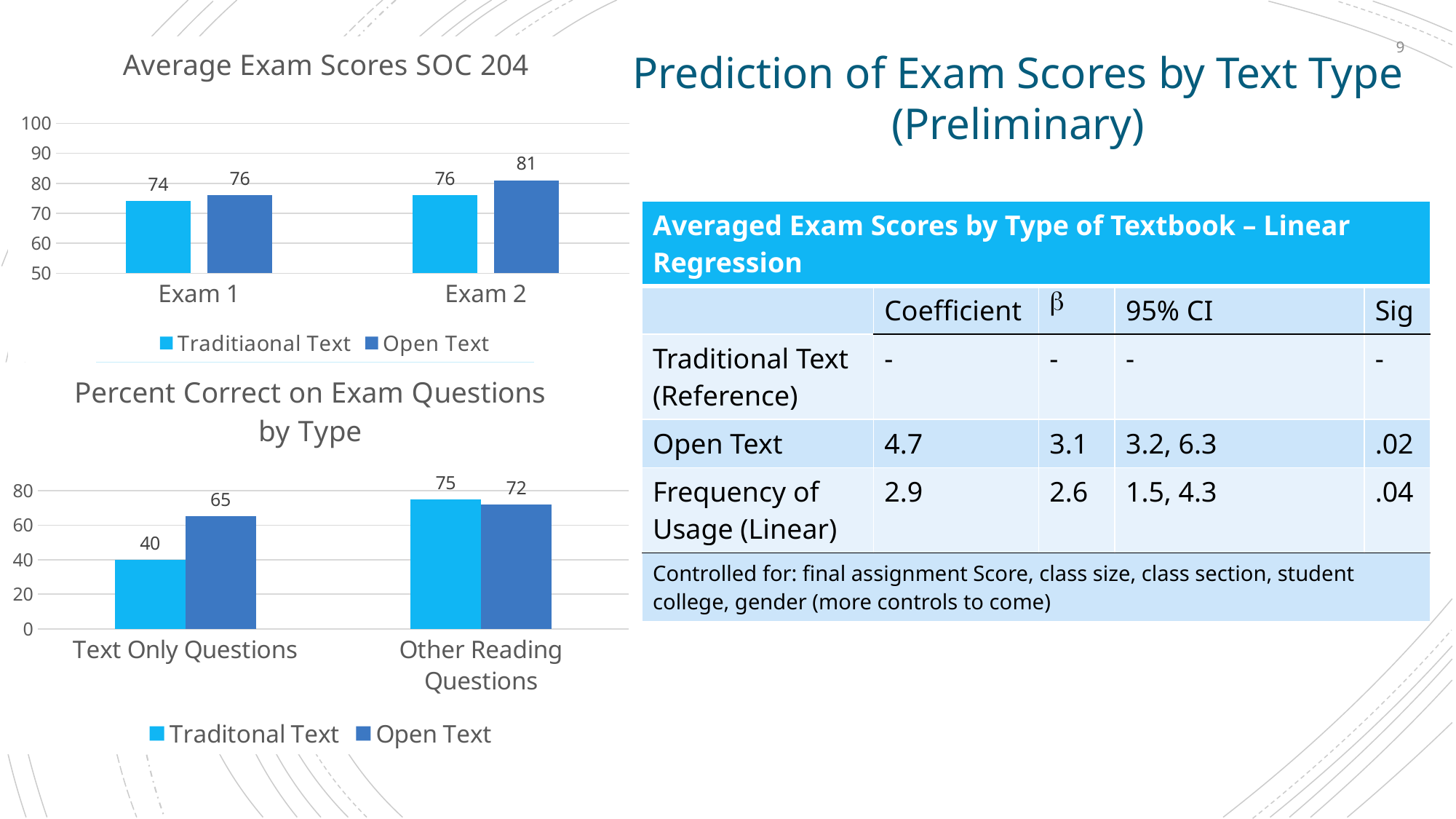
In the 'Percent Correct on Exam Questions by Type' chart, what is the value for Traditional Text on Text Only Questions? 40 In the 'Percent Correct on Exam Questions by Type' chart, which is larger on Other Reading Questions: Traditional Text or Open Text? Traditional Text In the 'Percent Correct on Exam Questions by Type' chart, which bar is the lowest? Traditional Text, Text Only Questions In the 'Percent Correct on Exam Questions by Type' chart, what is the value for Open Text on Other Reading Questions? 72 In the 'Percent Correct on Exam Questions by Type' chart, how many categories are shown on the x axis? 2 In the 'Average Exam Scores SOC 204' chart, what is the difference between Open Text and Traditional Text on Exam 2? 5 In the 'Average Exam Scores SOC 204' chart, how many series does the legend list? 2 In the 'Average Exam Scores SOC 204' chart, which is larger on Exam 1: Traditional Text or Open Text? Open Text In the 'Average Exam Scores SOC 204' chart, what is the value for Open Text on Exam 2? 81 What kind of chart is 'Average Exam Scores SOC 204'? Bar chart In the 'Average Exam Scores SOC 204' chart, what is the value for Traditional Text on Exam 1? 74 In the 'Percent Correct on Exam Questions by Type' chart, what is the difference between Open Text and Traditional Text on Text Only Questions? 25